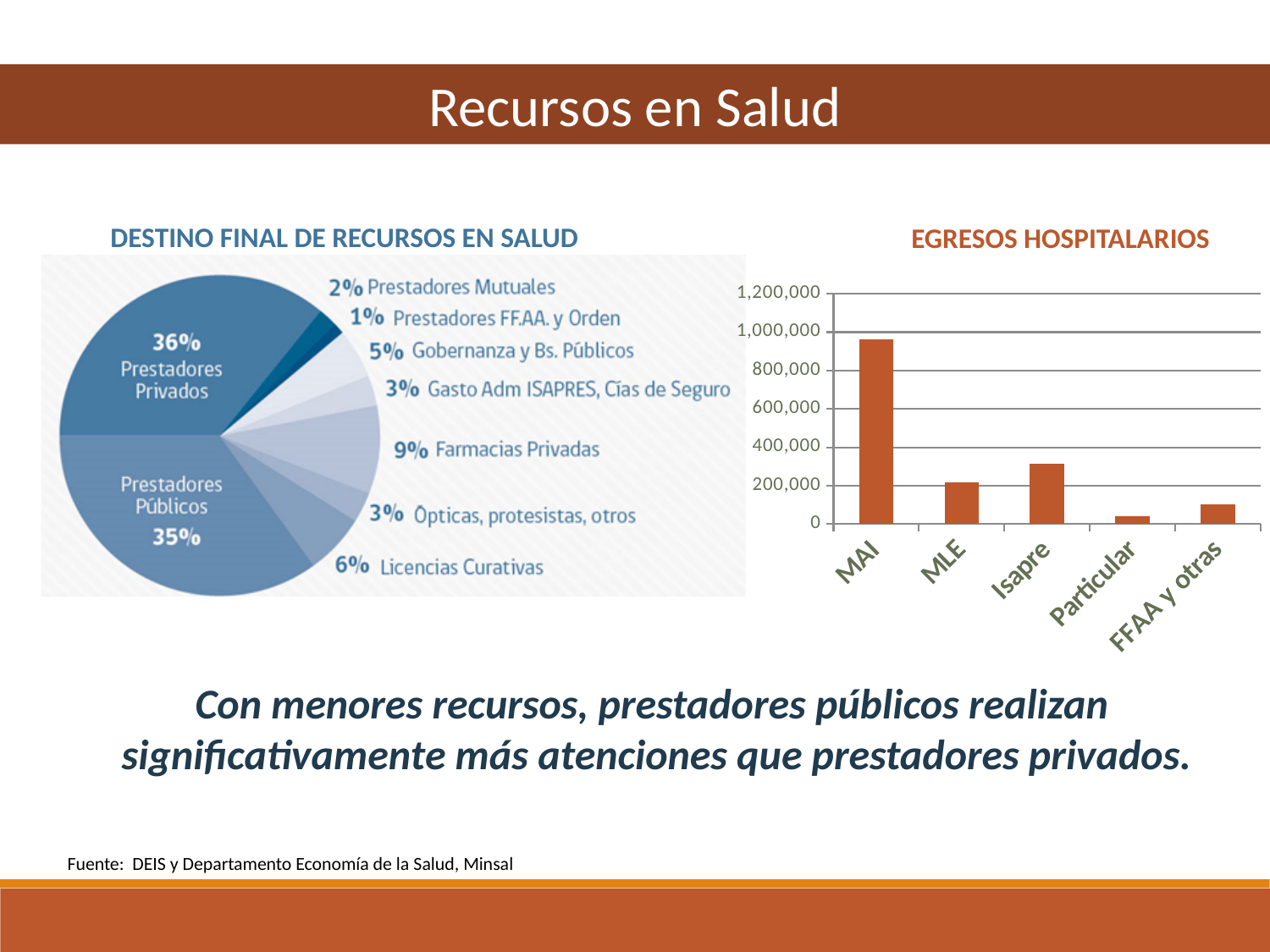
What kind of chart is DESTINO FINAL DE RECURSOS EN SALUD? Pie chart In the DESTINO FINAL DE RECURSOS EN SALUD pie chart, what share goes to Prestadores Privados? 36% What kind of chart is EGRESOS HOSPITALARIOS? Bar chart In the DESTINO FINAL DE RECURSOS EN SALUD pie chart, what share goes to Farmacias Privadas? 9% In the EGRESOS HOSPITALARIOS chart, which is larger, Isapre or MLE? Isapre In the EGRESOS HOSPITALARIOS chart, is the value for MAI greater or less than 800,000? greater In the DESTINO FINAL DE RECURSOS EN SALUD pie chart, which category has the smallest share? Prestadores FF.AA. y Orden In the EGRESOS HOSPITALARIOS chart, which category has the lowest value? Particular In the DESTINO FINAL DE RECURSOS EN SALUD pie chart, what share goes to Prestadores Públicos? 35% In the DESTINO FINAL DE RECURSOS EN SALUD pie chart, how many slices are labelled? 9 In the DESTINO FINAL DE RECURSOS EN SALUD pie chart, what is the difference between the shares of Licencias Curativas and Prestadores Mutuales? 4% In the EGRESOS HOSPITALARIOS chart, which category has the highest value? MAI